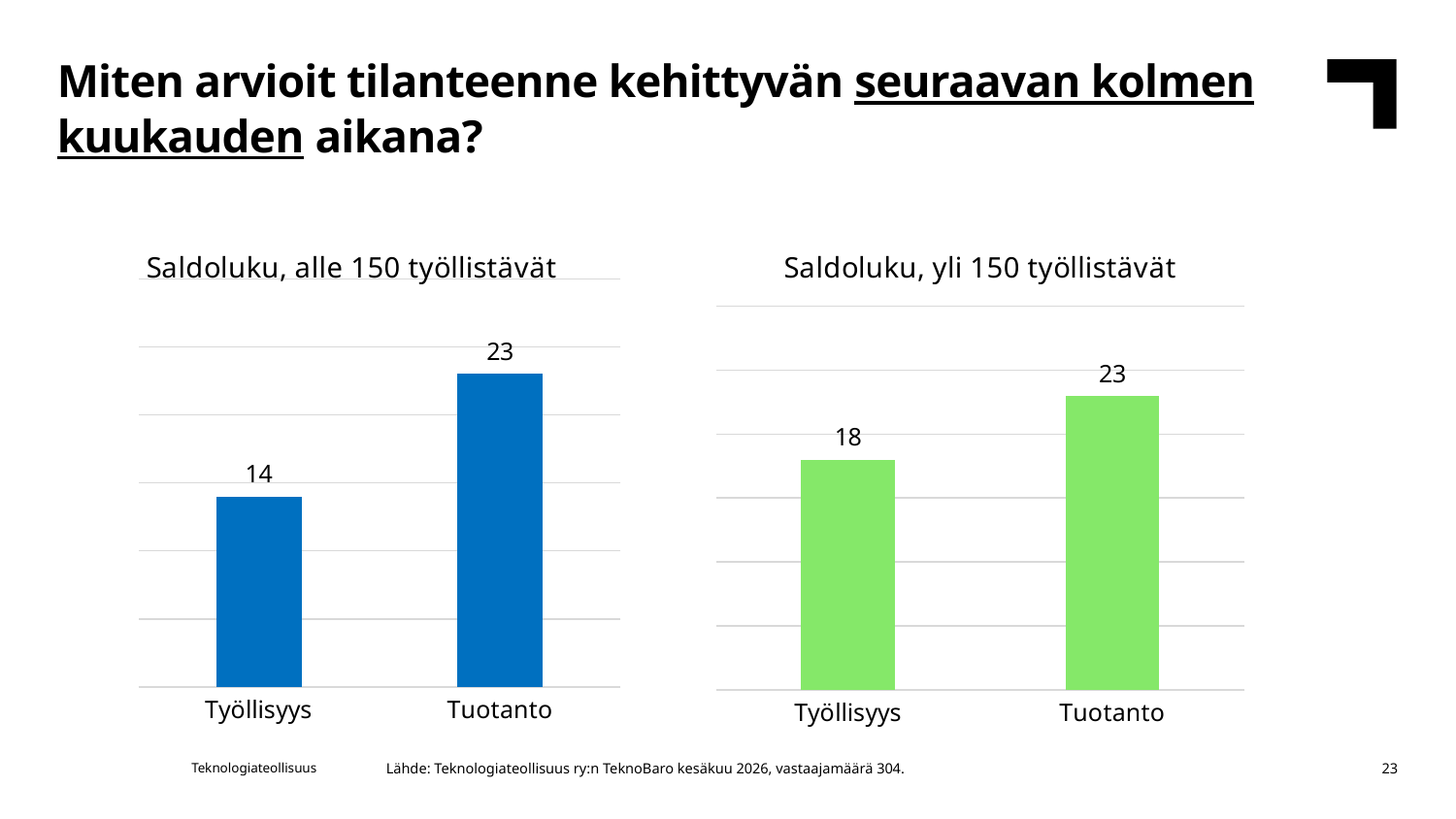
In the right chart (yli 150 työllistävät), which category has the lowest value? Työllisyys In the chart titled "Saldoluku, alle 150 työllistävät", what is the value for Työllisyys? 14 What colour are the bars in the chart titled "Saldoluku, yli 150 työllistävät"? Green In the chart titled "Saldoluku, yli 150 työllistävät", what is the value for Työllisyys? 18 In the left chart (alle 150 työllistävät), which category has the highest value? Tuotanto In the chart titled "Saldoluku, alle 150 työllistävät", what is the value for Tuotanto? 23 Is the value for Työllisyys larger in the left chart (alle 150 työllistävät) or in the right chart (yli 150 työllistävät)? Right chart (yli 150 työllistävät) In the right chart (yli 150 työllistävät), what is the difference between the values for Tuotanto and Työllisyys? 5 How many categories are shown in the chart titled "Saldoluku, alle 150 työllistävät"? 2 In the left chart (alle 150 työllistävät), what is the difference between the values for Tuotanto and Työllisyys? 9 In the chart titled "Saldoluku, yli 150 työllistävät", what is the value for Tuotanto? 23 What type of chart is the chart titled "Saldoluku, yli 150 työllistävät"? Bar chart